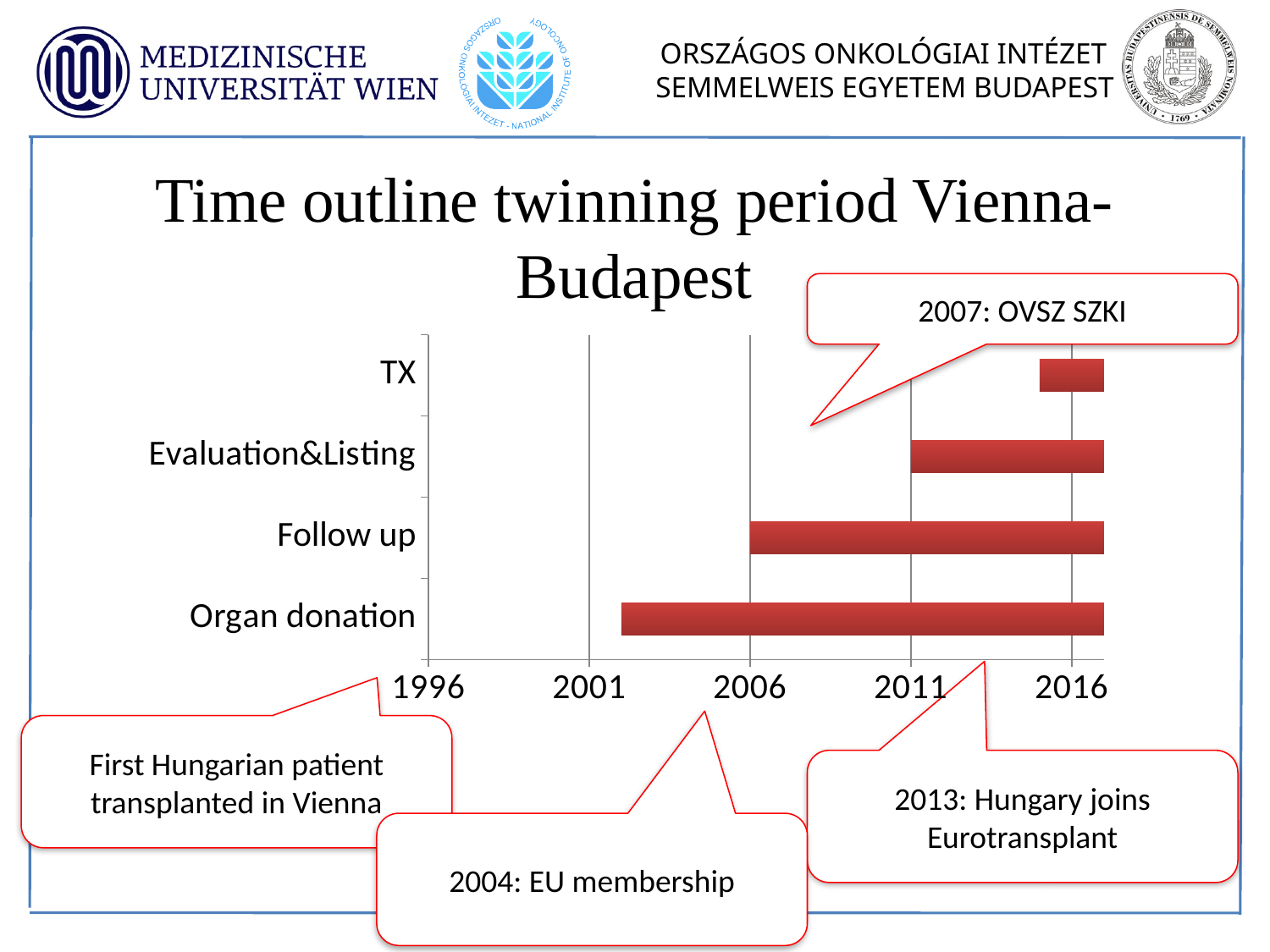
What is the title of the slide containing the chart? Time outline twinning period Vienna-Budapest What is the first year label shown on the horizontal axis? 1996 In which year does the Evaluation&Listing bar begin? 2011 In which year does the Follow up bar begin? 2006 Is the starting year of the TX bar greater or less than 2011? greater Which category has the shortest bar in the chart? TX What kind of chart is shown on the slide? bar chart How many categories are listed on the vertical axis of the chart? 4 Which category has the longest bar in the chart? Organ donation Which bar is longer, Organ donation or Follow up? Organ donation According to the callout on the slide, what happened in 2013? Hungary joins Eurotransplant Is the starting year of the Organ donation bar greater or less than 2001? greater